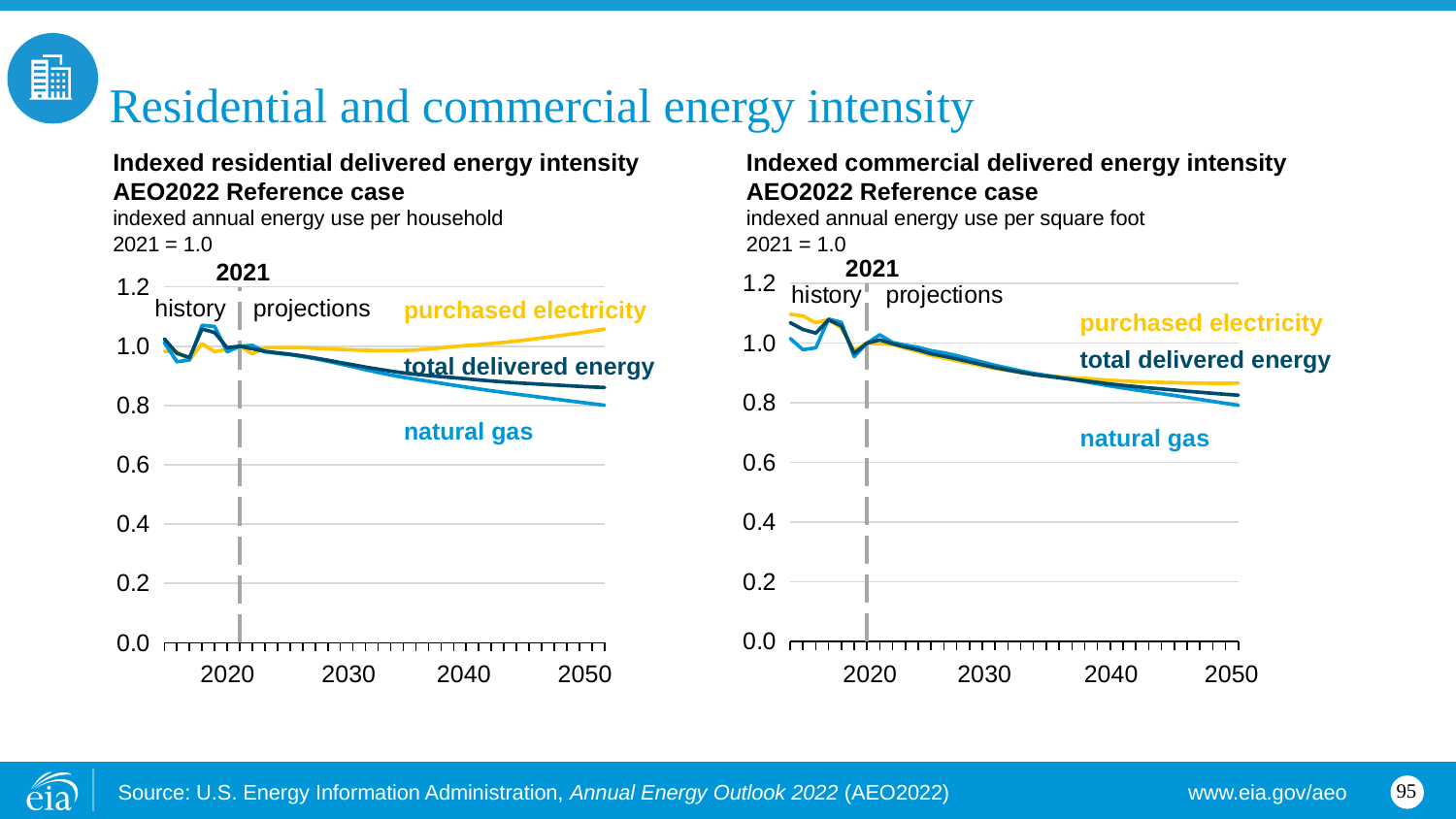
On the right chart (commercial), is the value for natural gas in 2050 greater or less than 0.6? greater What type of chart is the 'Indexed residential delivered energy intensity' chart on the left? line chart How many series are plotted on the 'Indexed commercial delivered energy intensity' chart on the right? 3 On the right chart (commercial), which is larger in 2050: purchased electricity or natural gas? purchased electricity On the left chart (residential), which year does the dashed vertical line separating history from projections mark? 2021 On the left chart (residential), is the value for purchased electricity in 2050 greater or less than 1.0? greater On the right chart (commercial), which series has the lowest value in 2050? natural gas On the left chart (residential), does purchased electricity rise or fall over the projection period from 2021 to 2050? rise On the left chart (residential), which series has the highest value in 2050? purchased electricity On the right chart (commercial), does total delivered energy rise or fall over the projection period from 2021 to 2050? fall On the left chart (residential), what is the indexed value of the series in the base year 2021? 1.0 On the left chart (residential), is the value for natural gas in 2050 greater or less than 1.0? less